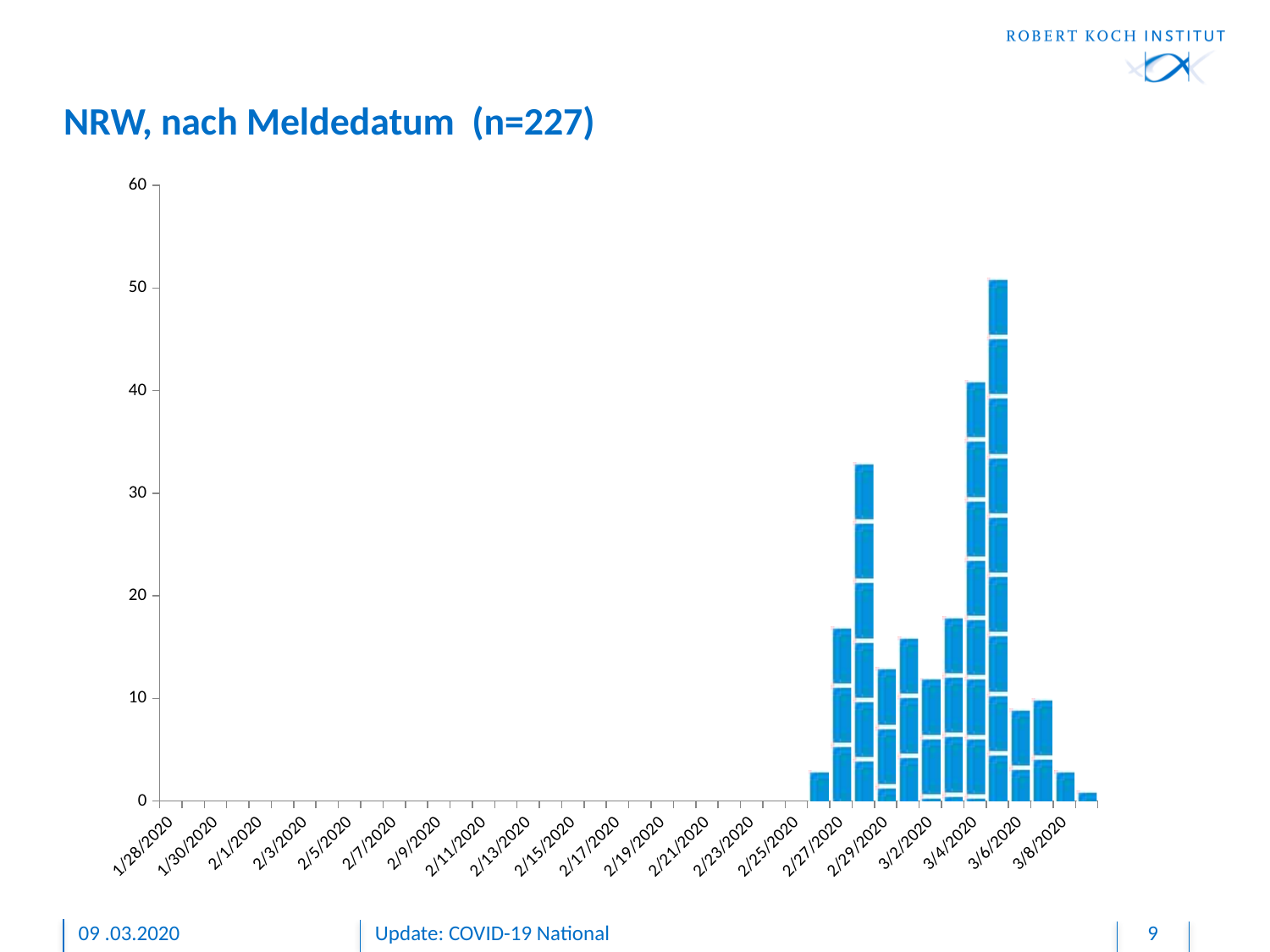
What kind of chart is shown on the slide? bar chart Is the value for 3/6/2020 greater or less than 20? less Is the value for 3/2/2020 greater or less than 20? less Which date has the larger value, 2/27/2020 or 3/2/2020? 2/27/2020 Is the value for 3/8/2020 greater or less than 10? less What is the title of the chart? NRW, nach Meldedatum (n=227) Which date has the larger value, 3/4/2020 or 2/27/2020? 3/4/2020 What is the total number of cases (n) given in the chart title? 227 How many date labels are shown on the x axis? 21